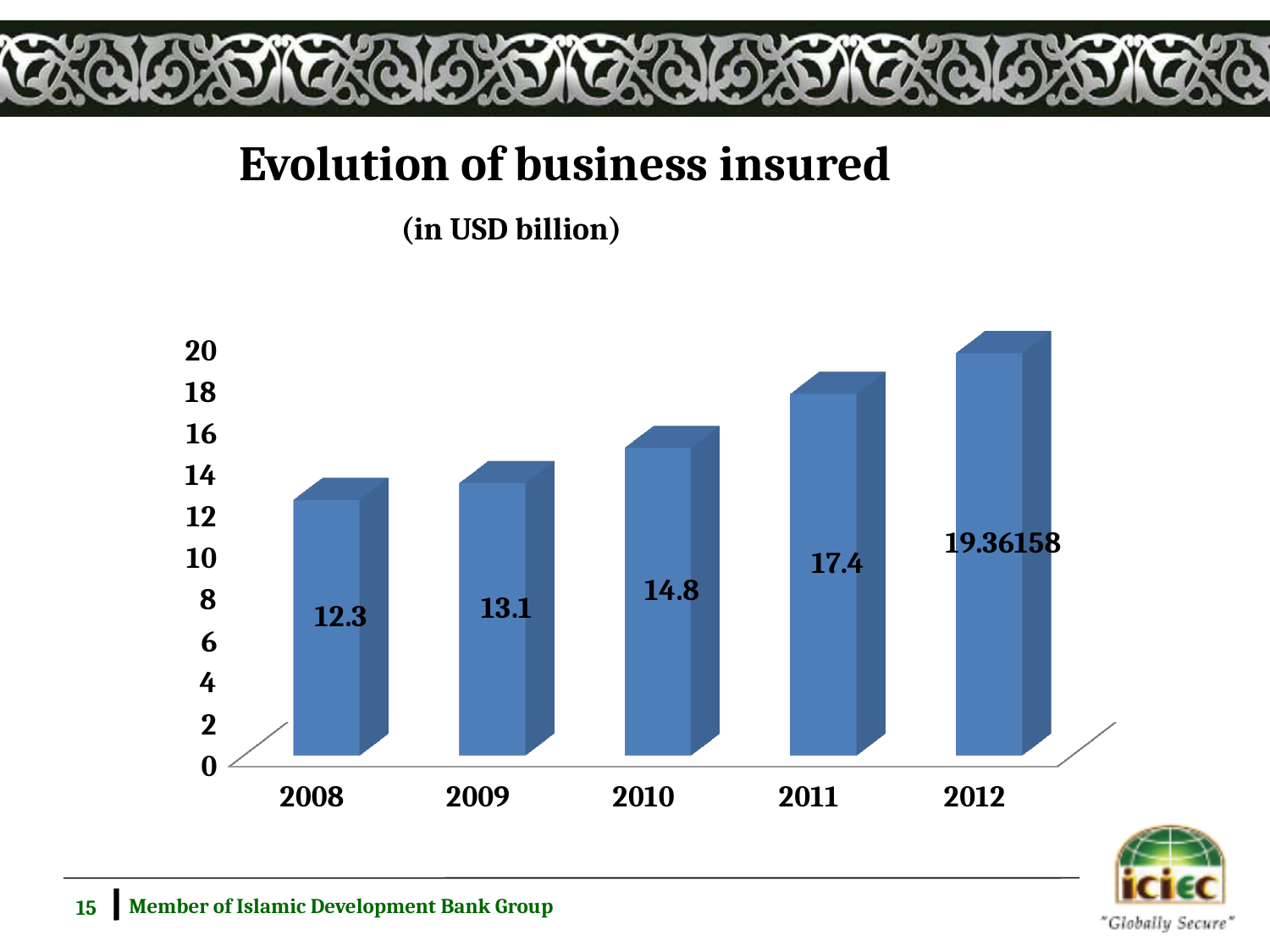
Which year has the lowest value of business insured? 2008 What is the difference between the values for 2009 and 2008? 0.8 Is the value for 2011 greater or less than 16? greater What is the value of business insured for 2008? 12.3 Which year has a larger value, 2009 or 2011? 2011 What is the value of business insured for 2012? 19.36158 What is the value of business insured for 2010? 14.8 What kind of chart is shown on the slide? bar chart How many years are shown on the chart? 5 Which year has the highest value of business insured? 2012 What is the difference between the values for 2011 and 2010? 2.6 Do the values rise or fall from 2008 to 2012? rise